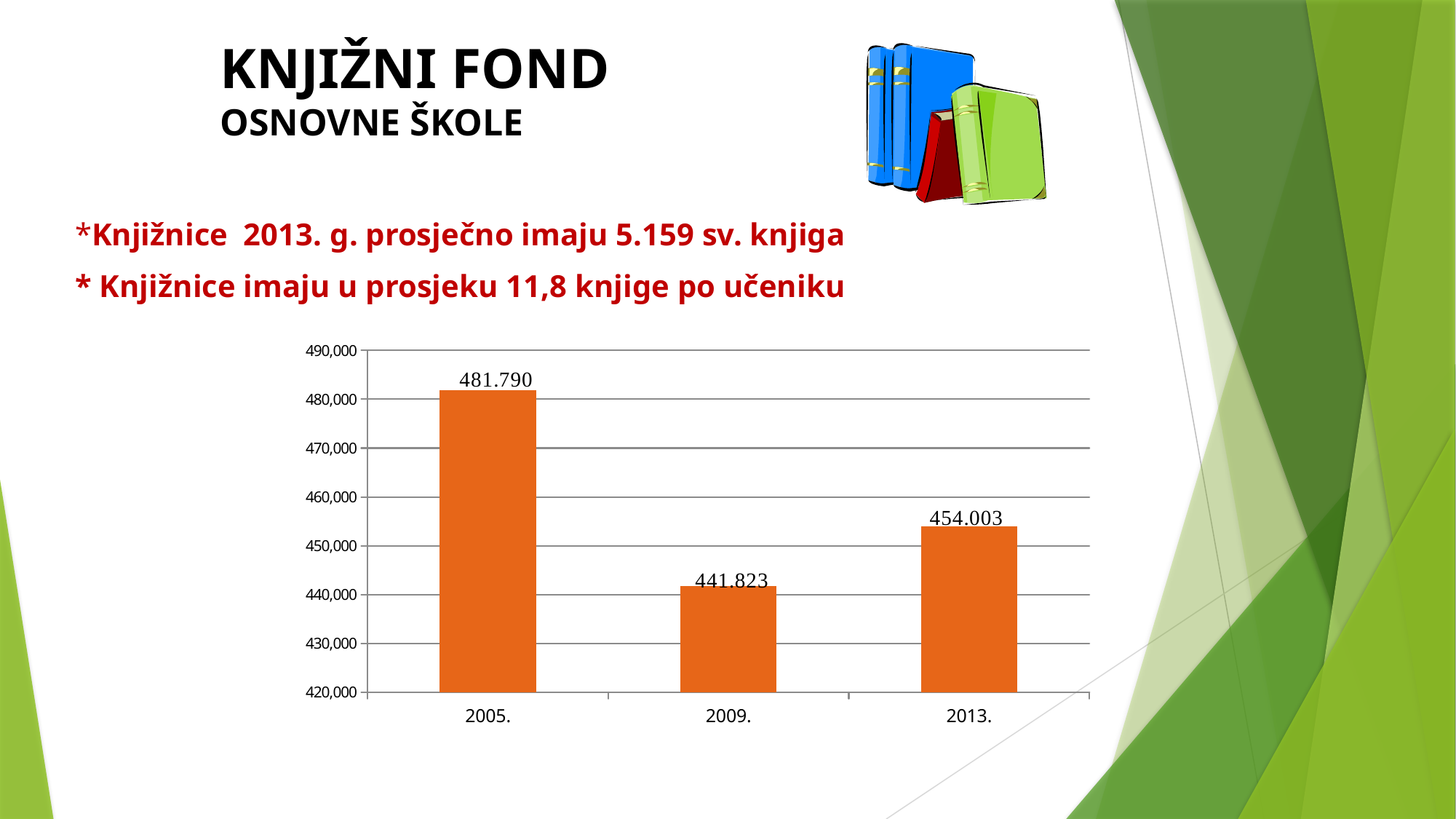
What is the value shown for 2005.? 481.790 Which is larger, the value for 2013. or the value for 2009.? 2013. What is the difference between the values for 2005. and 2009.? 39.967 What is the difference between the values for 2013. and 2009.? 12.180 What kind of chart is shown on the slide? bar chart What is the value shown for 2009.? 441.823 Which year has the lowest value? 2009. How many years are shown on the x axis? 3 Which year has the highest value? 2005. What colour are the bars in the chart? orange What is the value shown for 2013.? 454.003 Is the value for 2013. greater or less than 460,000? less